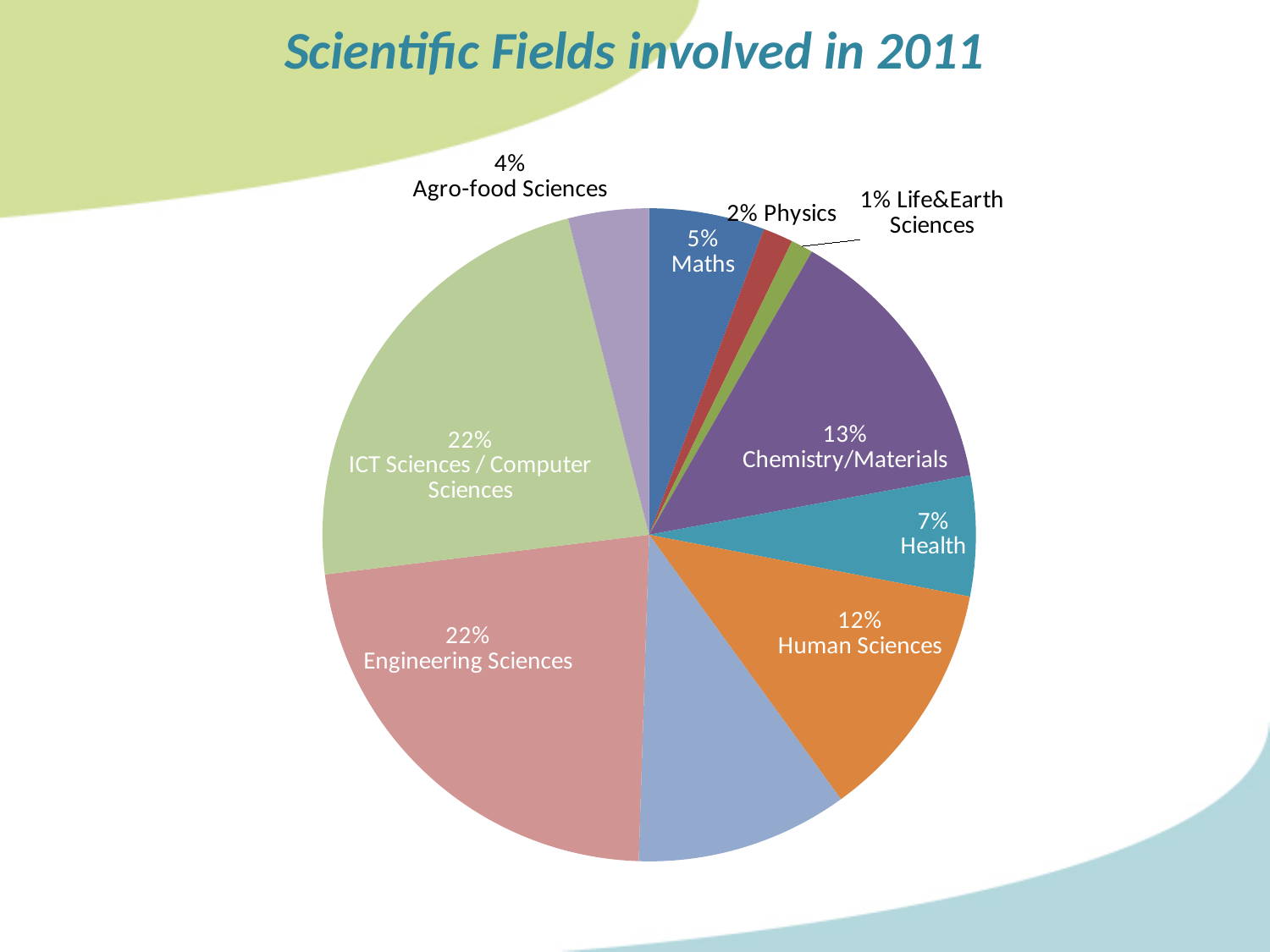
What percentage is shown for Health? 7% Which has a larger share, Health or Human Sciences? Human Sciences What percentage is shown for Maths? 5% What share of the pie does Chemistry/Materials represent? 13% What is the difference in percentage points between Chemistry/Materials and Human Sciences? 1 What percentage is shown for Engineering Sciences? 22% What is the title of the chart? Scientific Fields involved in 2011 What percentage is shown for Agro-food Sciences? 4% What type of chart is shown on the slide? pie chart How many slices does the pie chart have? 10 Which labeled field has the smallest share of the pie? Life&Earth Sciences What is the combined share of ICT Sciences / Computer Sciences and Engineering Sciences? 44%